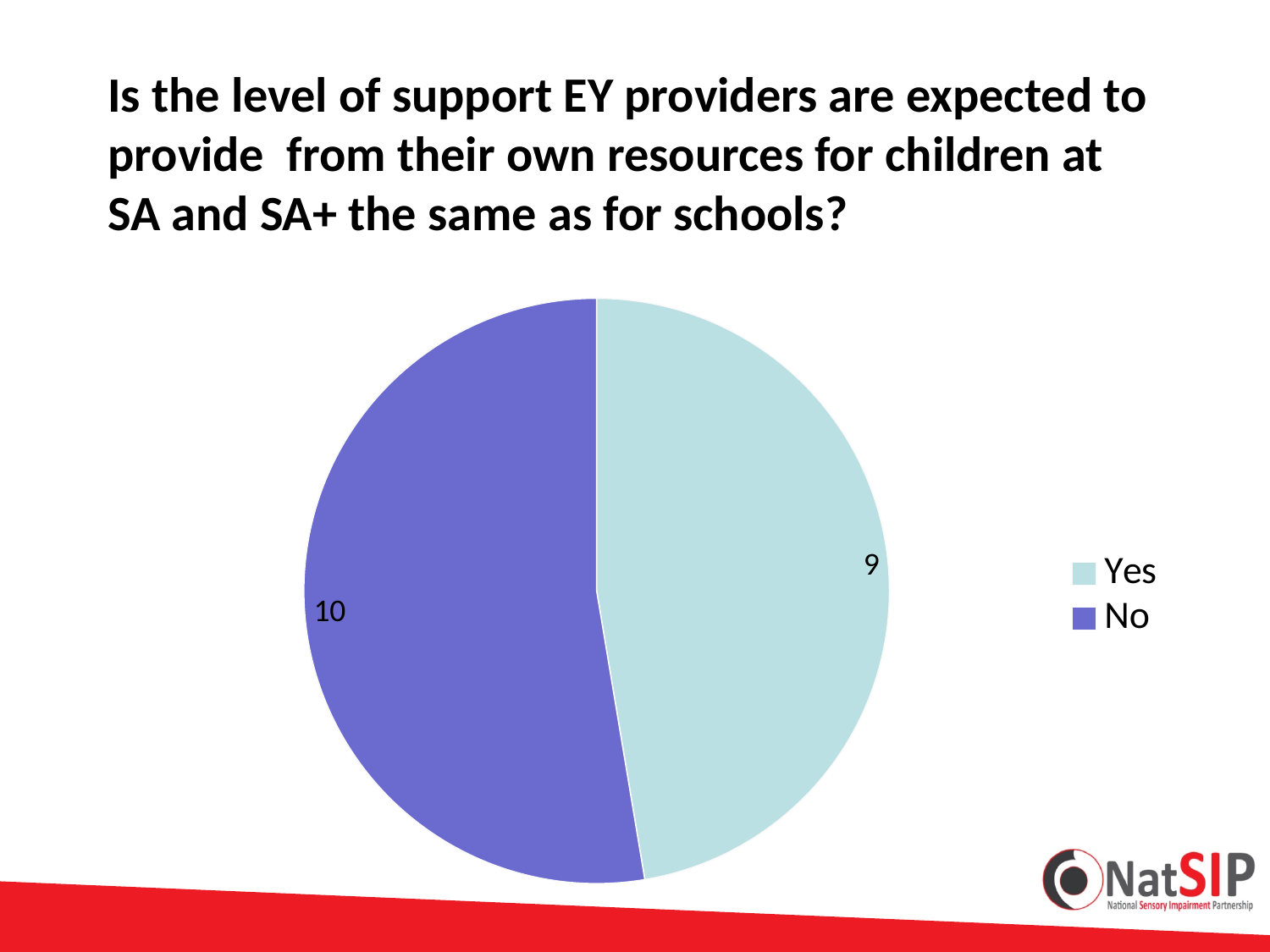
Which response has the smallest slice? Yes What is the total of all slices in the pie chart? 19 What is the title of the slide above the chart? Is the level of support EY providers are expected to provide from their own resources for children at SA and SA+ the same as for schools? Which colour represents the No slice? purple What is the difference between the No and Yes counts? 1 How many respondents answered Yes? 9 How many slices does the pie chart have? 2 Which response has the larger slice, Yes or No? No What kind of chart is shown on the slide? pie chart How many respondents answered No? 10 How many entries does the legend list? 2